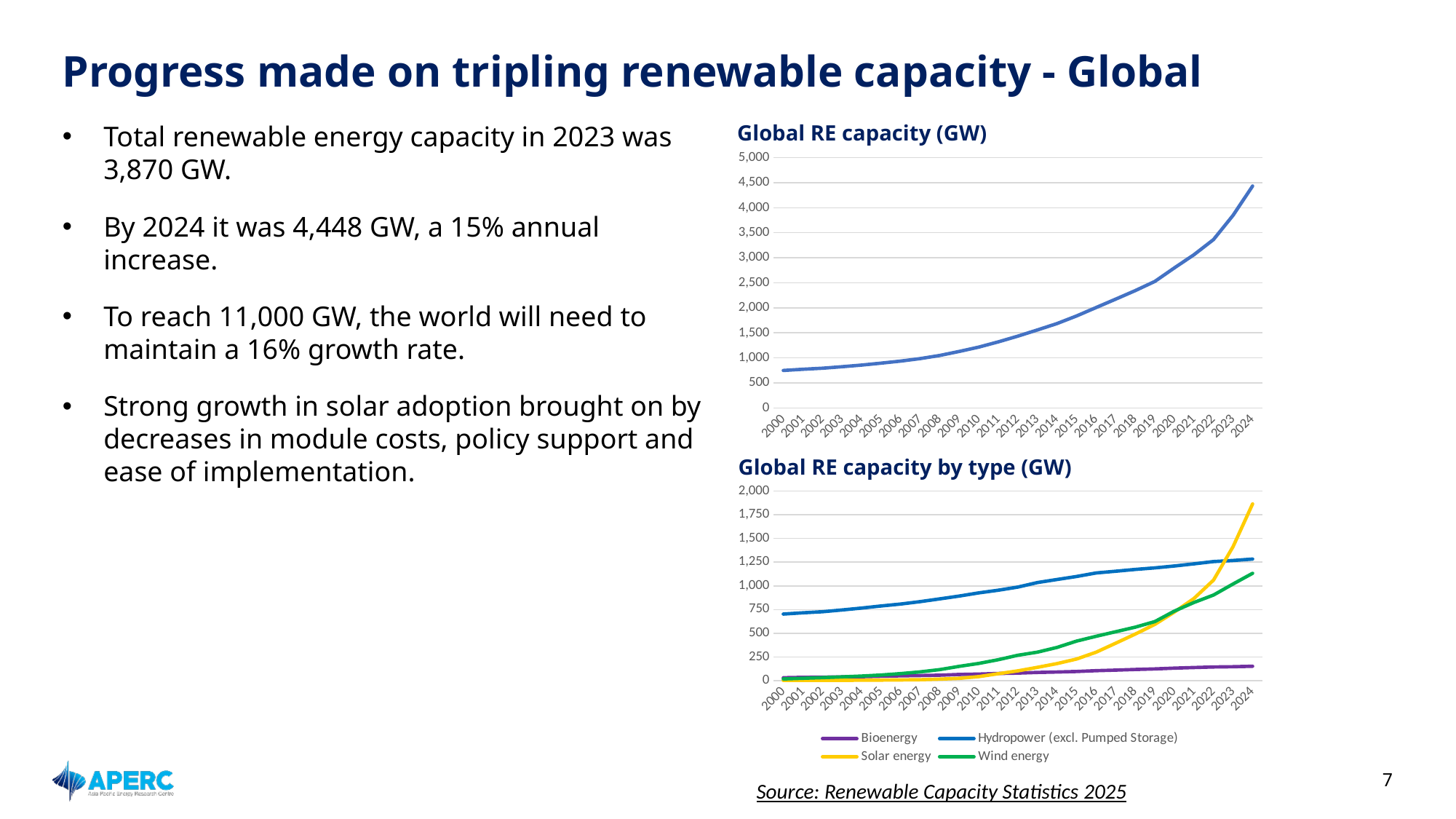
In the 'Global RE capacity by type (GW)' chart, which series has the highest value in 2024? Solar energy In the 'Global RE capacity by type (GW)' chart, which series has the highest value in 2000? Hydropower (excl. Pumped Storage) In the 'Global RE capacity (GW)' chart, is the value for 2024 greater or less than 4,000? greater In the 'Global RE capacity (GW)' chart, is the value for 2000 greater or less than 1,000? less In the 'Global RE capacity by type (GW)' chart, what colour is the Solar energy line? Yellow In the 'Global RE capacity by type (GW)' chart, which is larger in 2010: Hydropower (excl. Pumped Storage) or Wind energy? Hydropower (excl. Pumped Storage) How many series does the legend of the 'Global RE capacity by type (GW)' chart list? 4 How many years are shown on the x axis of the 'Global RE capacity (GW)' chart? 25 In the 'Global RE capacity (GW)' chart, does the line rise or fall from 2000 to 2024? Rises What kind of chart is the 'Global RE capacity (GW)' chart? Line chart What kind of chart is the 'Global RE capacity by type (GW)' chart? Line chart In the 'Global RE capacity by type (GW)' chart, which series has the lowest value in 2024? Bioenergy